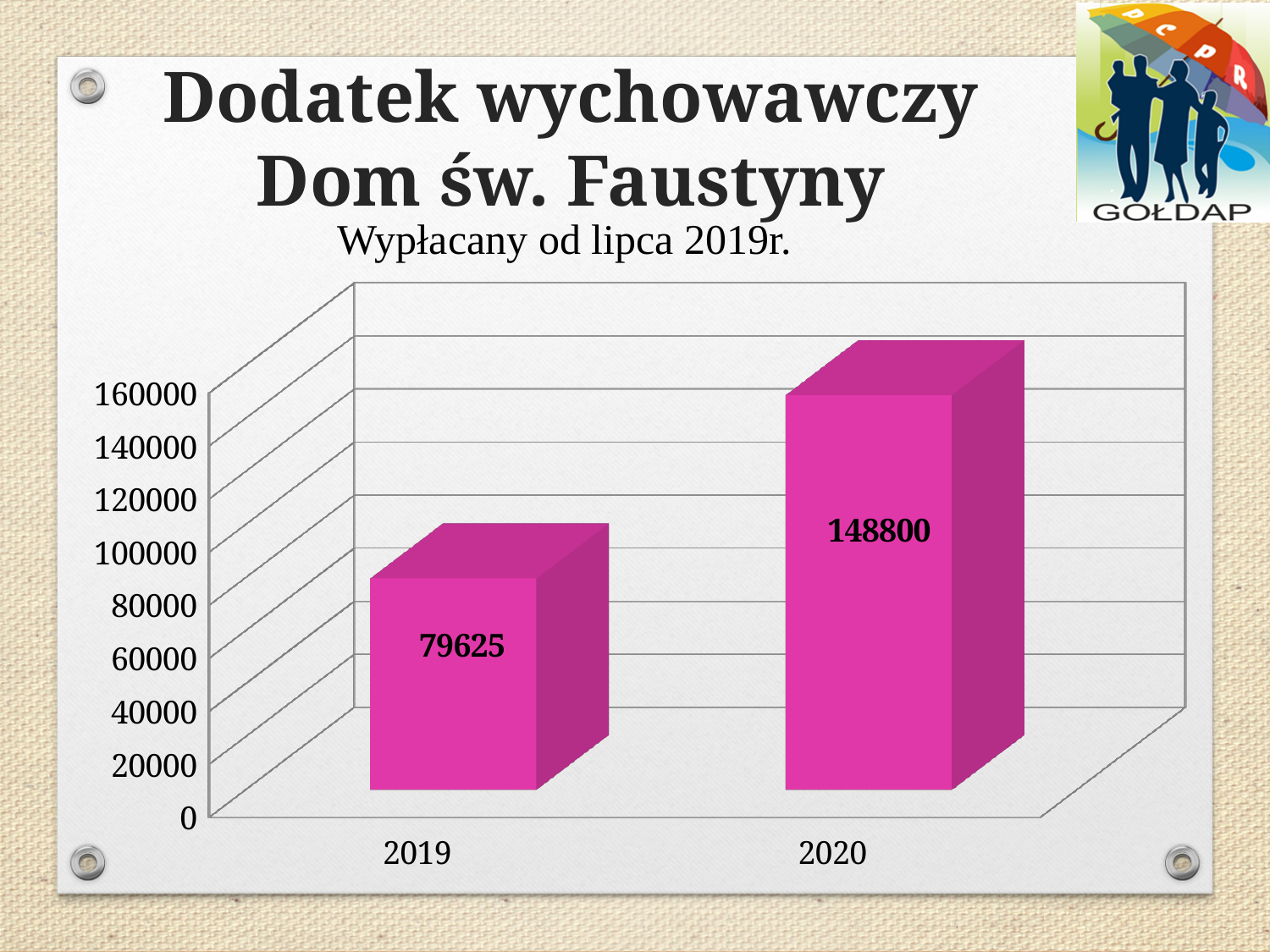
What is the difference between the values for 2020 and 2019? 69175 Which is larger, the value for 2019 or the value for 2020? 2020 What is the value for 2020? 148800 Which year has the highest value? 2020 What is the value for 2019? 79625 What kind of chart is shown on the slide? bar chart Is the value for 2019 greater or less than 100000? less Which year has the lowest value? 2019 Is the value for 2020 greater or less than 140000? greater Do the values rise or fall from 2019 to 2020? rise How many categories are shown on the x axis? 2 What colour are the bars in the chart? magenta (pink)